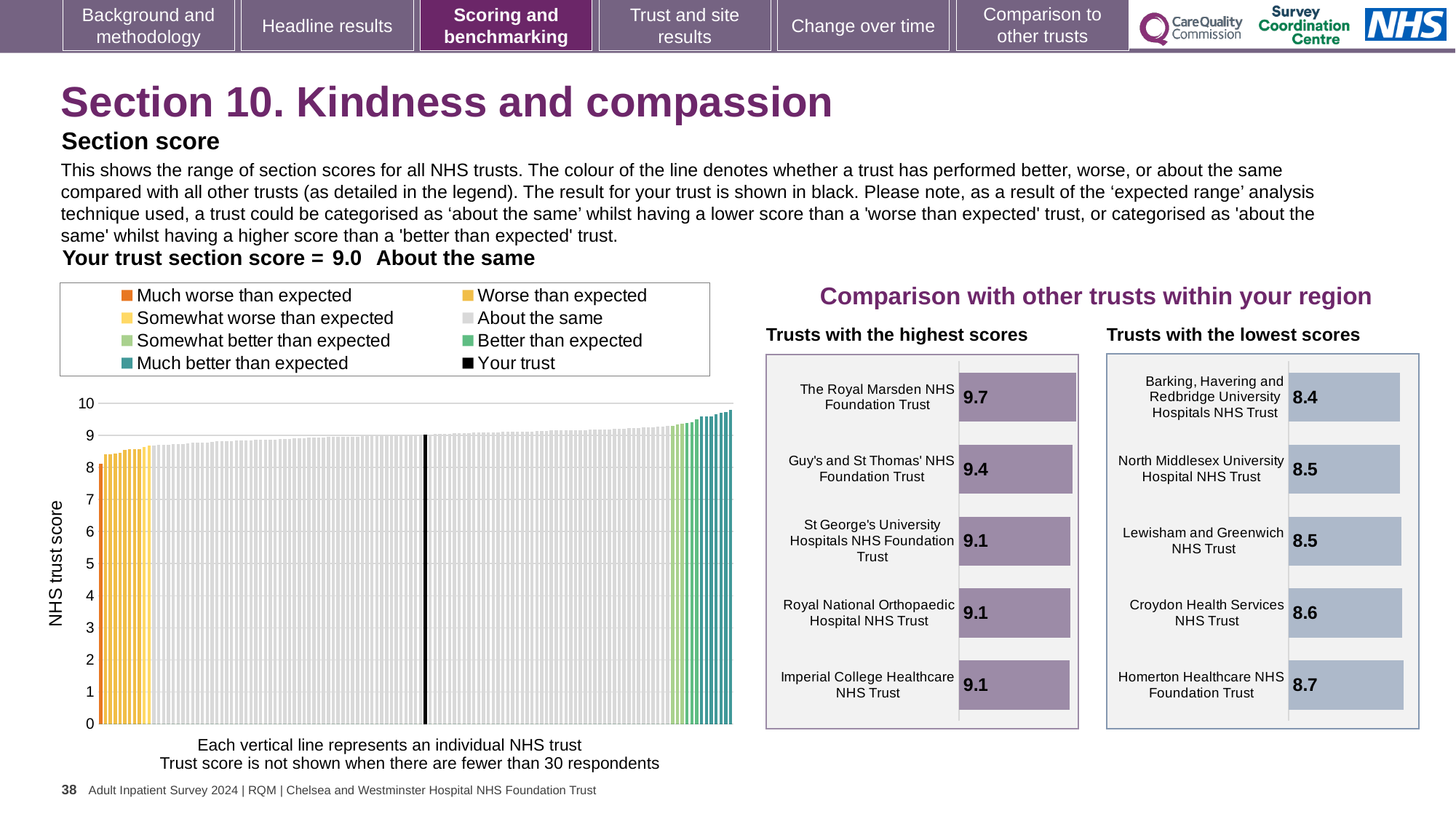
How many trusts are listed in the 'Trusts with the highest scores' chart? 5 In the 'Trusts with the highest scores' chart, what is the score for The Royal Marsden NHS Foundation Trust? 9.7 In the 'Trusts with the highest scores' chart, which trust has the highest score? The Royal Marsden NHS Foundation Trust In the 'Trusts with the lowest scores' chart, what is the score for Croydon Health Services NHS Trust? 8.6 What kind of chart is the main chart on the left showing the range of section scores? Bar chart In the 'Trusts with the lowest scores' chart, which has the larger score: Homerton Healthcare NHS Foundation Trust or North Middlesex University Hospital NHS Trust? Homerton Healthcare NHS Foundation Trust In the main chart on the left, what is the label on the vertical axis? NHS trust score In the main chart on the left, do the trust scores rise or fall from left to right? Rise In the 'Trusts with the highest scores' chart, what is the difference between the scores of The Royal Marsden NHS Foundation Trust and Guy's and St Thomas' NHS Foundation Trust? 0.3 In the 'Trusts with the lowest scores' chart, which trust has the lowest score? Barking, Havering and Redbridge University Hospitals NHS Trust In the main chart on the left, how many entries does the legend list? 8 In the main chart on the left, is the value of the rightmost bar greater or less than 9? greater